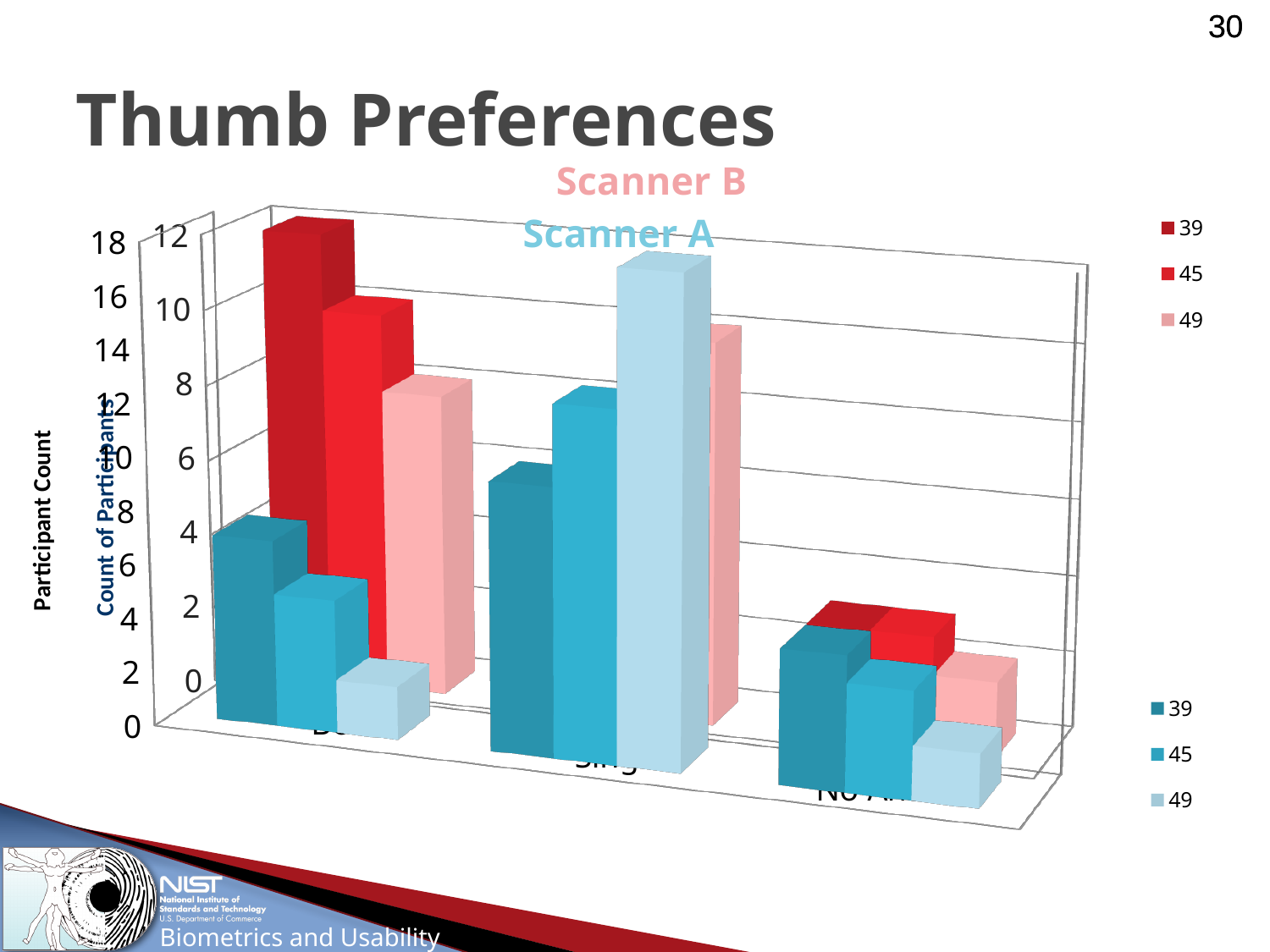
How many series does the Scanner A legend list? 3 In the Scanner B chart, in the leftmost group, which bar is taller: 39 or 49? 39 What is the title of the chart drawn in blue shades? Scanner A In the Scanner A chart, in the middle group, which bar is taller: 49 or 39? 49 In the Scanner A chart, which series has the tallest bar overall? 49 How many category groups does the Scanner B chart show? 3 What are the legend entries of the Scanner B chart? 39, 45, 49 In the Scanner B chart, which series has the shortest bar in the leftmost group? 49 How many series does the Scanner B legend list? 3 In the Scanner A chart, which series has the shortest bar in the rightmost group? 49 In the Scanner B chart, which series has the tallest bar overall? 39 What kind of chart is the Scanner A chart? bar chart